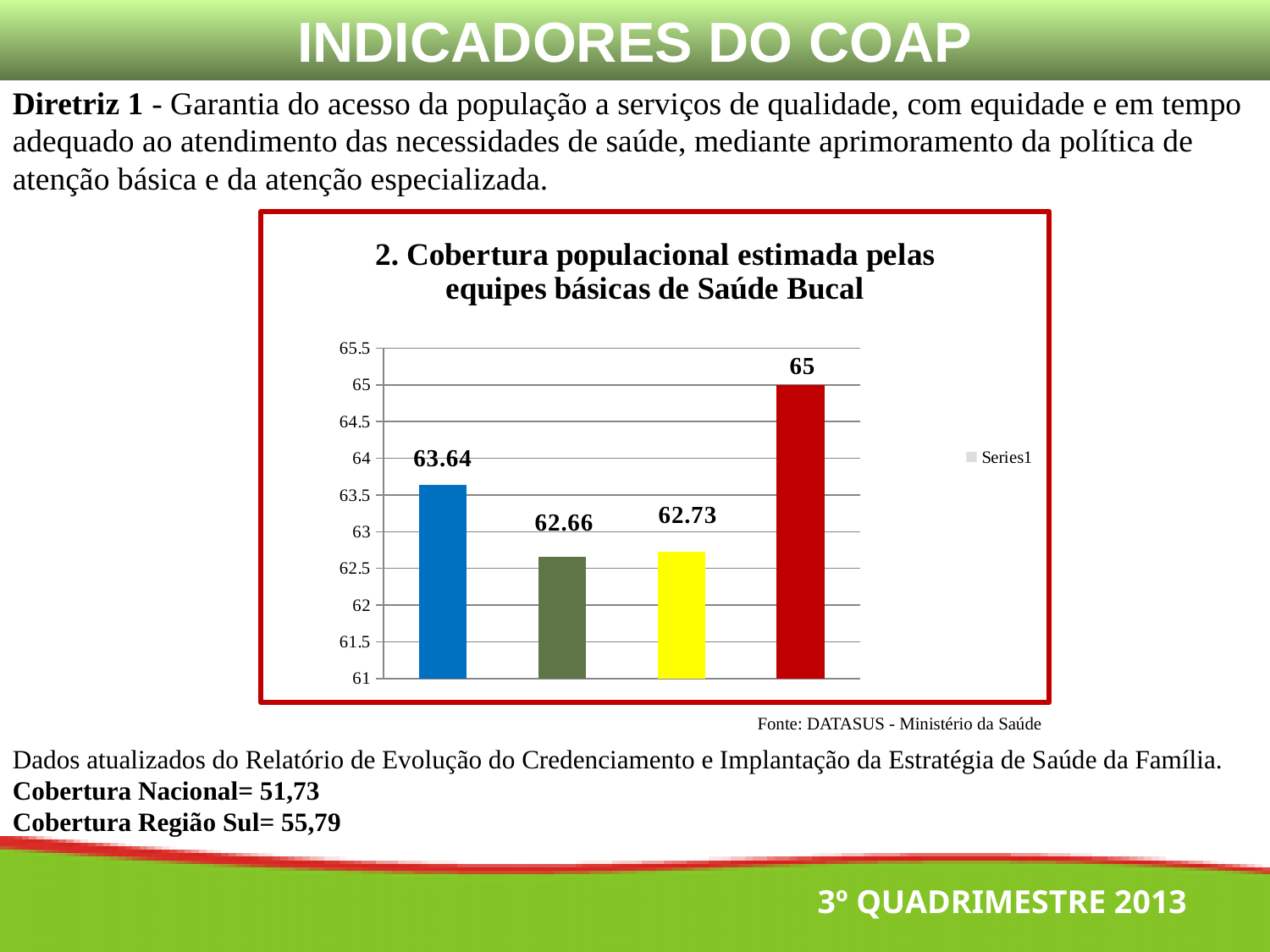
Which is larger, the value of the blue bar or the value of the yellow bar? the blue bar What is the value of the yellow (third) bar? 62.73 What type of chart is shown on the slide? bar chart Which bar has the highest value? the red (fourth) bar What is the value of the blue (first) bar? 63.64 How many bars are plotted in the chart? 4 Which bar has the lowest value? the green (second) bar What is the title of the chart? 2. Cobertura populacional estimada pelas equipes básicas de Saúde Bucal What is the difference between the red bar's value and the blue bar's value? 1.36 What is the value of the red (fourth) bar? 65 What is the value of the green (second) bar? 62.66 How many series does the chart legend list? 1